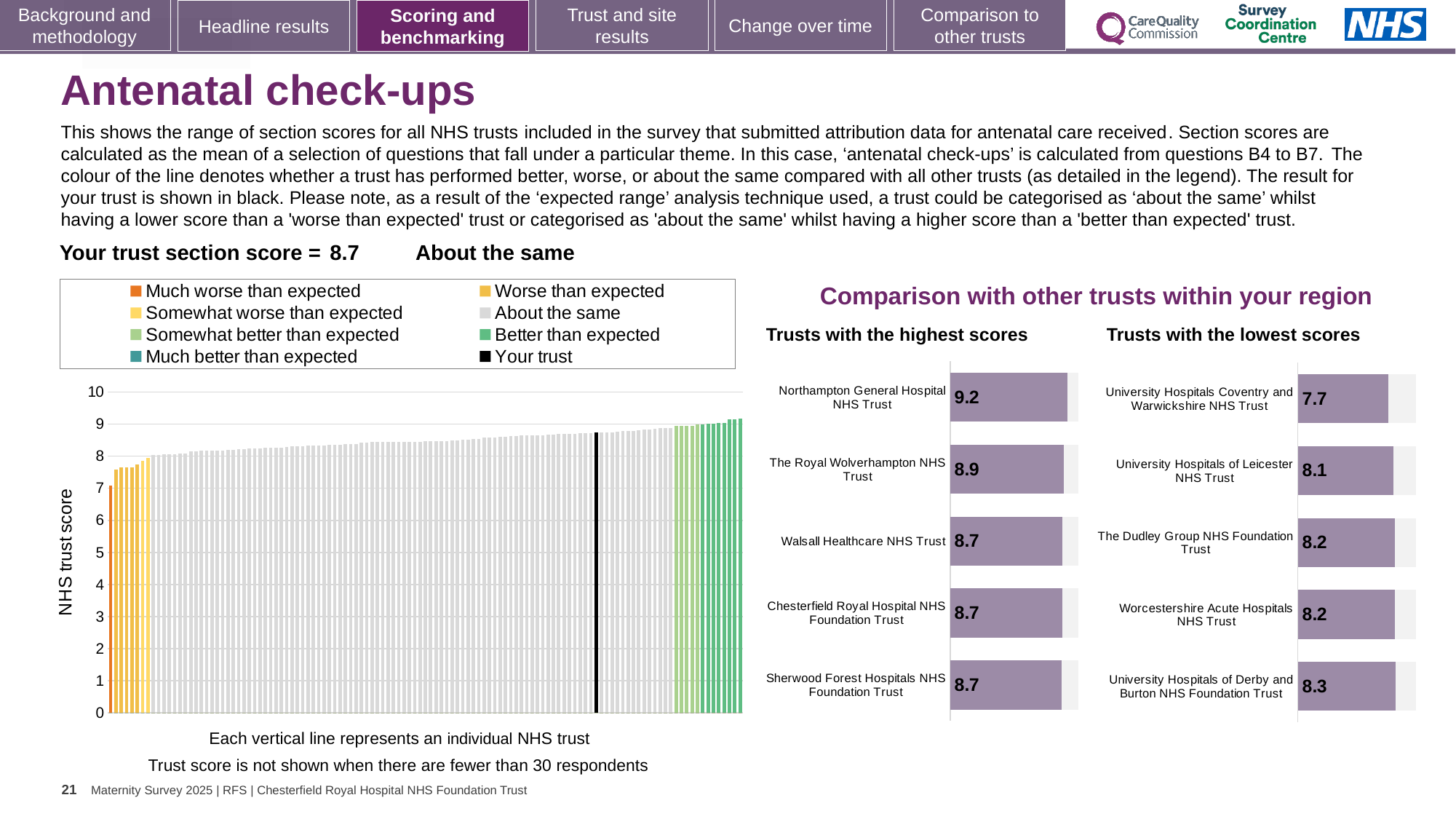
In the 'Trusts with the highest scores' chart, which trust has the highest score? Northampton General Hospital NHS Trust In the 'Trusts with the lowest scores' chart, which trust has the lowest score? University Hospitals Coventry and Warwickshire NHS Trust In the 'Trusts with the highest scores' chart, what is the score for Northampton General Hospital NHS Trust? 9.2 In the 'Trusts with the lowest scores' chart, what is the score for The Dudley Group NHS Foundation Trust? 8.2 In the 'Trusts with the lowest scores' chart, which has the larger score: University Hospitals of Leicester NHS Trust or University Hospitals of Derby and Burton NHS Foundation Trust? University Hospitals of Derby and Burton NHS Foundation Trust How many trusts are listed in the 'Trusts with the highest scores' chart? 5 In the large chart on the left, is the value of the leftmost (orange) bar greater or less than 8? less In the large chart on the left, do the trust scores rise or fall from left to right? Rise In the 'Trusts with the lowest scores' chart, what is the score for University Hospitals Coventry and Warwickshire NHS Trust? 7.7 What kind of chart is the large chart on the left showing NHS trust scores? Bar chart How many entries does the legend above the large chart on the left list? 8 In the 'Trusts with the highest scores' chart, what is the difference between the scores of Northampton General Hospital NHS Trust and The Royal Wolverhampton NHS Trust? 0.3